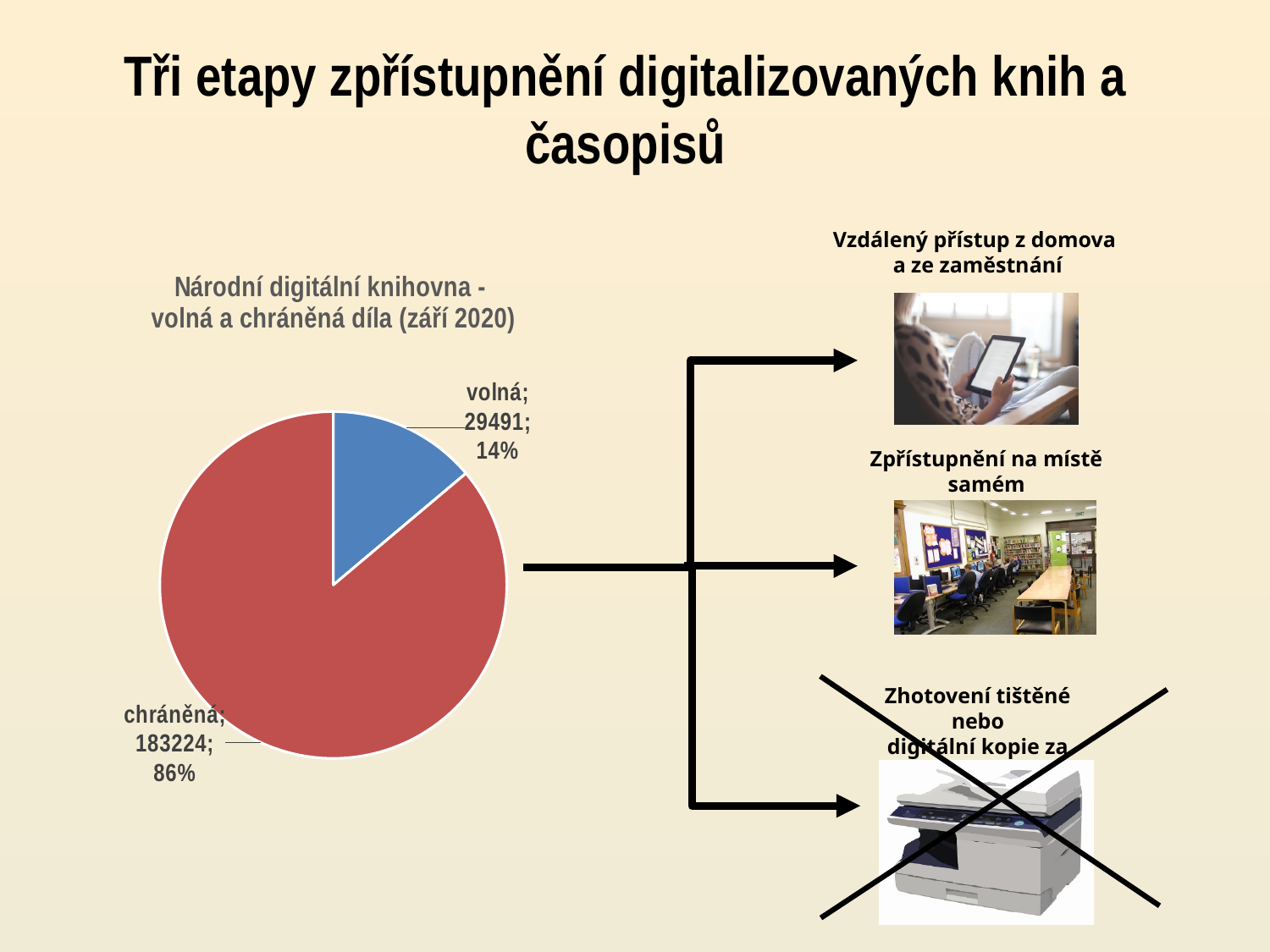
What is the value for 'volná' in the pie chart? 29491 How many slices does the pie chart have? 2 What kind of chart is shown on the slide? pie chart Which is larger, the value for 'volná' or the value for 'chráněná'? chráněná Which category has the smallest slice in the pie chart? volná What colour is the 'volná' slice in the pie chart? blue What share of the pie does 'chráněná' represent? 86% What is the difference between the values for 'chráněná' and 'volná'? 153733 Which category has the largest slice in the pie chart? chráněná What is the title of the pie chart? Národní digitální knihovna - volná a chráněná díla (září 2020) What share of the pie does 'volná' represent? 14% What is the value for 'chráněná' in the pie chart? 183224